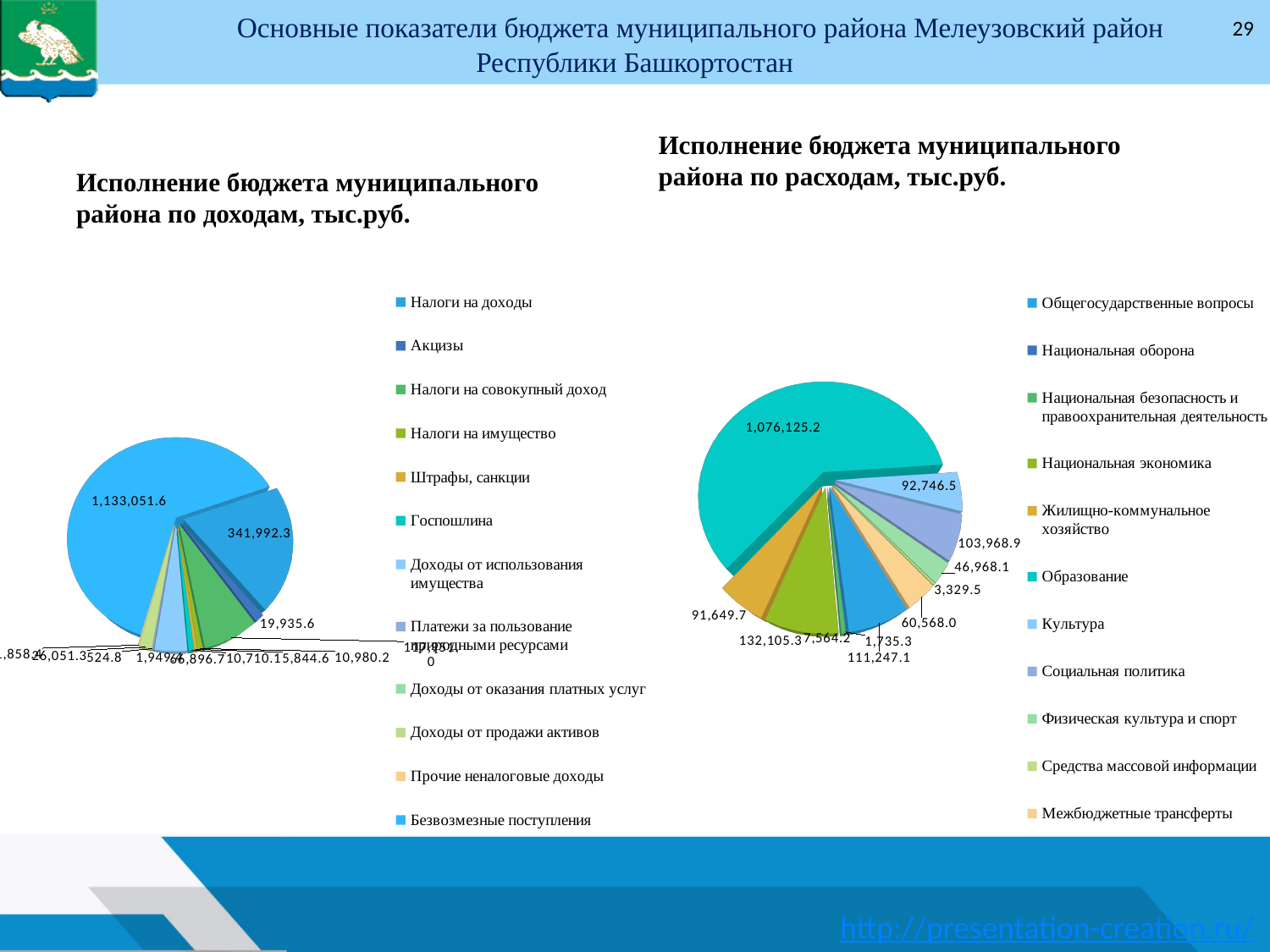
In the left chart (доходы), what is the difference between the two largest labelled slices, 1,133,051.6 and 341,992.3? 791,059.3 In the right chart (расходы), what is the difference between the largest slice, 1,076,125.2, and the slice labelled 132,105.3? 944,019.9 What kind of chart is used on the right side of the slide for 'Исполнение бюджета муниципального района по расходам'? pie chart In the right chart (расходы), what is the value shown for Образование? 1,076,125.2 What is the last legend entry of the right chart (расходы)? Межбюджетные трансферты How many categories does the legend of the right chart (расходы) list? 11 How many categories does the legend of the left chart (доходы) list? 12 In the right chart (расходы), which is larger: the slice labelled 111,247.1 or the slice labelled 60,568.0? 111,247.1 In the right chart (расходы), which category has the largest slice? Образование What unit is stated in the titles of both charts? тыс.руб. In the left chart (доходы), what is the largest value printed on the pie? 1,133,051.6 What kind of chart is used on the left side of the slide for 'Исполнение бюджета муниципального района по доходам'? pie chart